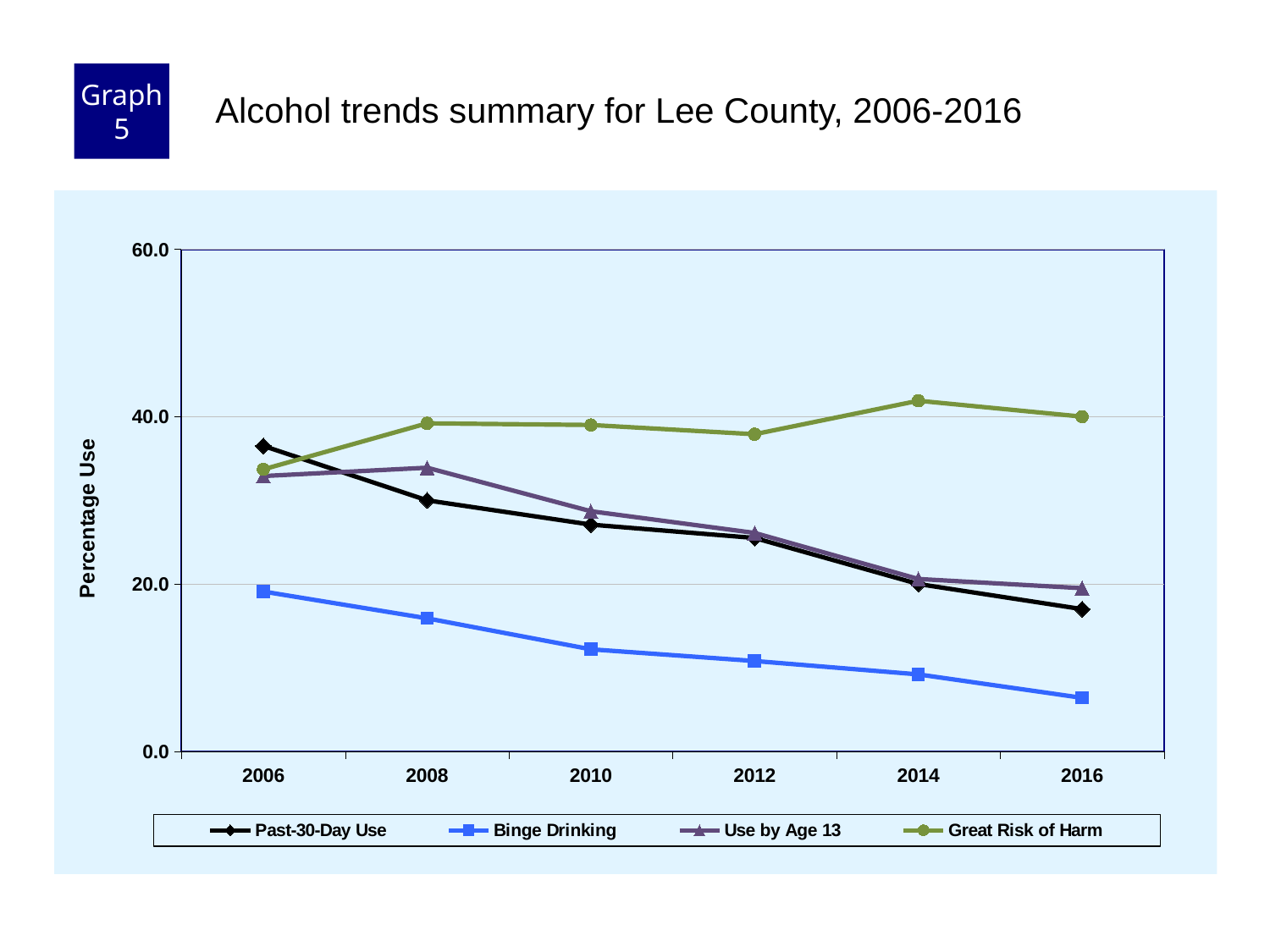
In 2006, which is larger: Past-30-Day Use or Binge Drinking? Past-30-Day Use How many series does the legend list? 4 What kind of chart is shown on the slide? line chart What is the label on the y axis? Percentage Use Is the value for Binge Drinking in 2006 greater or less than 20.0? less How many years are plotted along the x axis? 6 Is the value for Great Risk of Harm in 2014 greater or less than 40.0? greater Does the Past-30-Day Use series rise or fall from 2006 to 2016? fall Does the Binge Drinking series rise or fall from 2006 to 2016? fall Is the value for Past-30-Day Use in 2008 greater or less than 40.0? less Which series has the lowest value in 2016? Binge Drinking Which series has the highest value in 2014? Great Risk of Harm